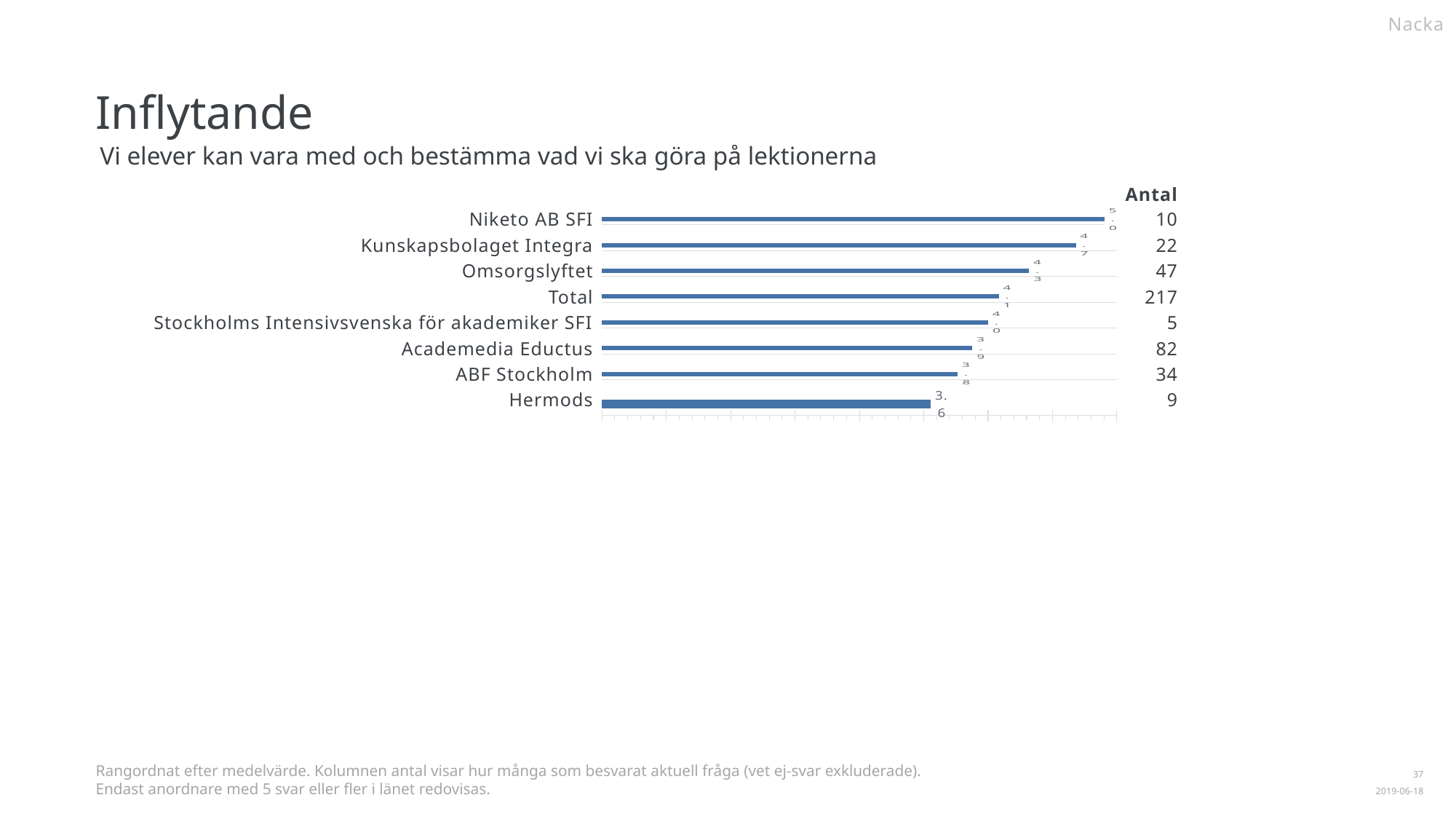
What is the difference between the values for Niketo AB SFI and Hermods? 1.4 Which category has the lowest value in the chart? Hermods What is the value shown for Total? 4.1 How many categories (bars) does the chart show? 8 What is the Antal shown for Total? 217 Which category has the highest value in the chart? Niketo AB SFI What type of chart is shown on the slide? bar chart Which has a larger value, Kunskapsbolaget Integra or Academedia Eductus? Kunskapsbolaget Integra What is the value shown for Hermods? 3.6 What is the subtitle (question text) shown above the chart? Vi elever kan vara med och bestämma vad vi ska göra på lektionerna What is the Antal (number of respondents) shown for Academedia Eductus? 82 What is the value shown for Niketo AB SFI? 5.0